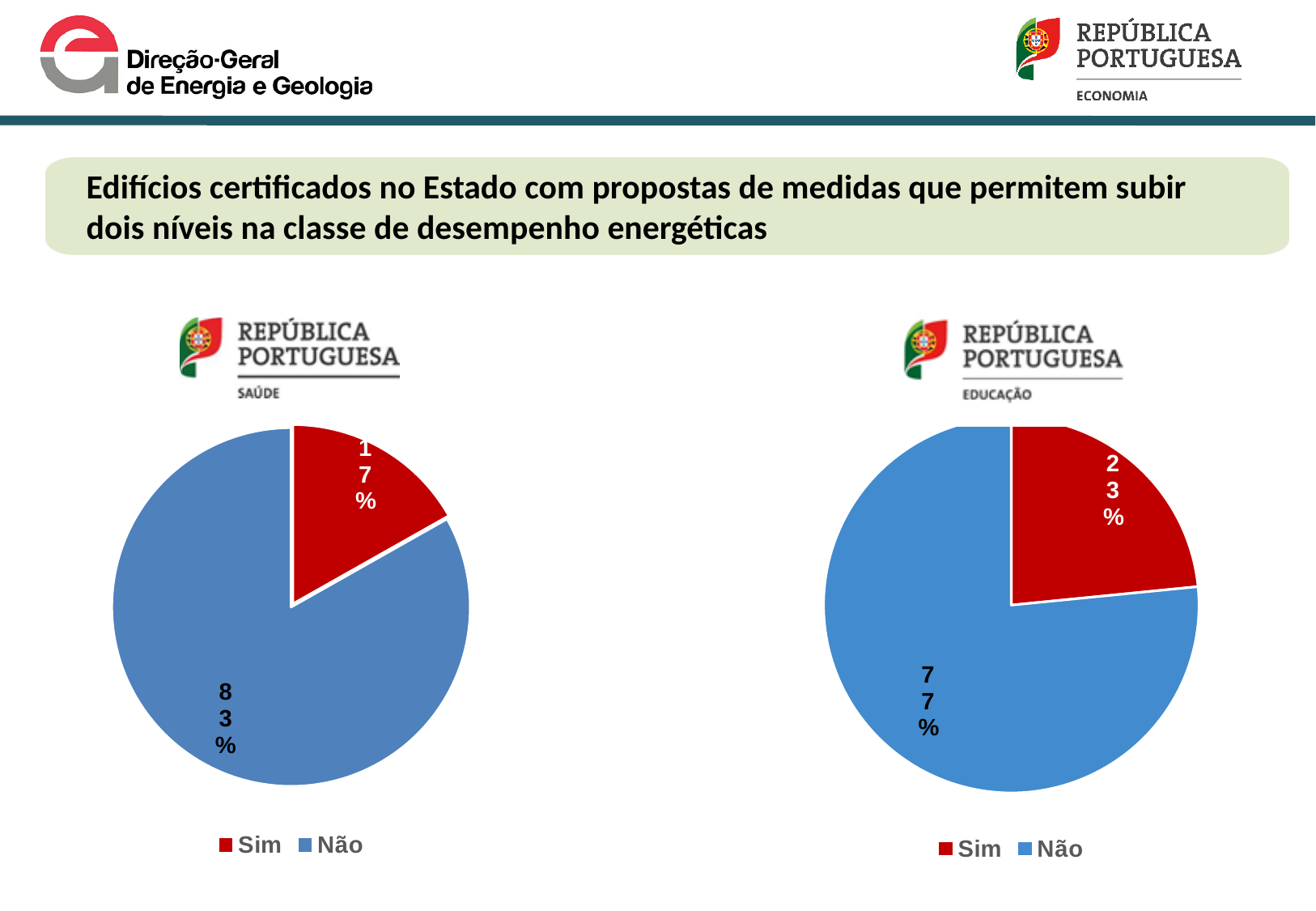
Which chart has the larger Sim share, the left (SAÚDE) or the right (EDUCAÇÃO)? Right (EDUCAÇÃO) What is the difference between the Não and Sim shares in the left pie chart (SAÚDE)? 66% What type of chart is used on this slide? Pie chart In the right pie chart (EDUCAÇÃO), what percentage is shown for Sim? 23% What is the difference between the Não and Sim shares in the right pie chart (EDUCAÇÃO)? 54% How many categories does the legend of the left pie chart (SAÚDE) list? 2 In the left pie chart (SAÚDE), what percentage is shown for Sim? 17% In the right pie chart (EDUCAÇÃO), what colour represents Sim? Red In the right pie chart (EDUCAÇÃO), which category has the smallest share? Sim In the right pie chart (EDUCAÇÃO), what percentage is shown for Não? 77% In the left pie chart (SAÚDE), which category has the largest share? Não In the left pie chart (SAÚDE), what percentage is shown for Não? 83%